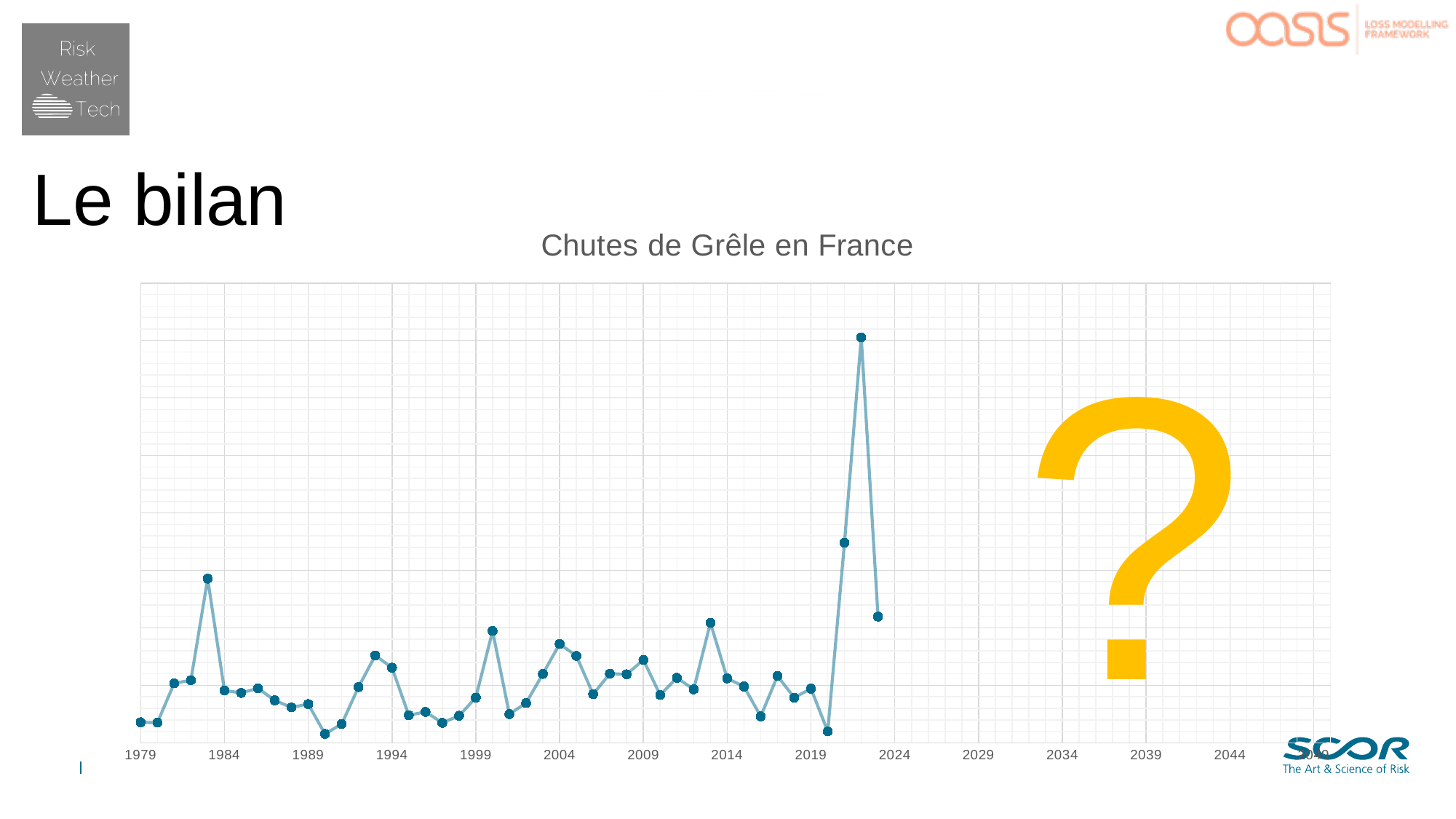
What kind of chart is shown on the slide? line chart Which year has the larger value, 1979 or 1983? 1983 Which year has the larger value, 1983 or 2000? 1983 What is the first year label on the x axis? 1979 How many data points are plotted on the line? 45 Does the value rise or fall from 2022 to 2023? fall Does the value rise or fall from 2020 to 2022? rise What is the title of the chart? Chutes de Grêle en France In which year does the chart reach its highest value? 2022 Which year has the larger value, 2022 or 2023? 2022